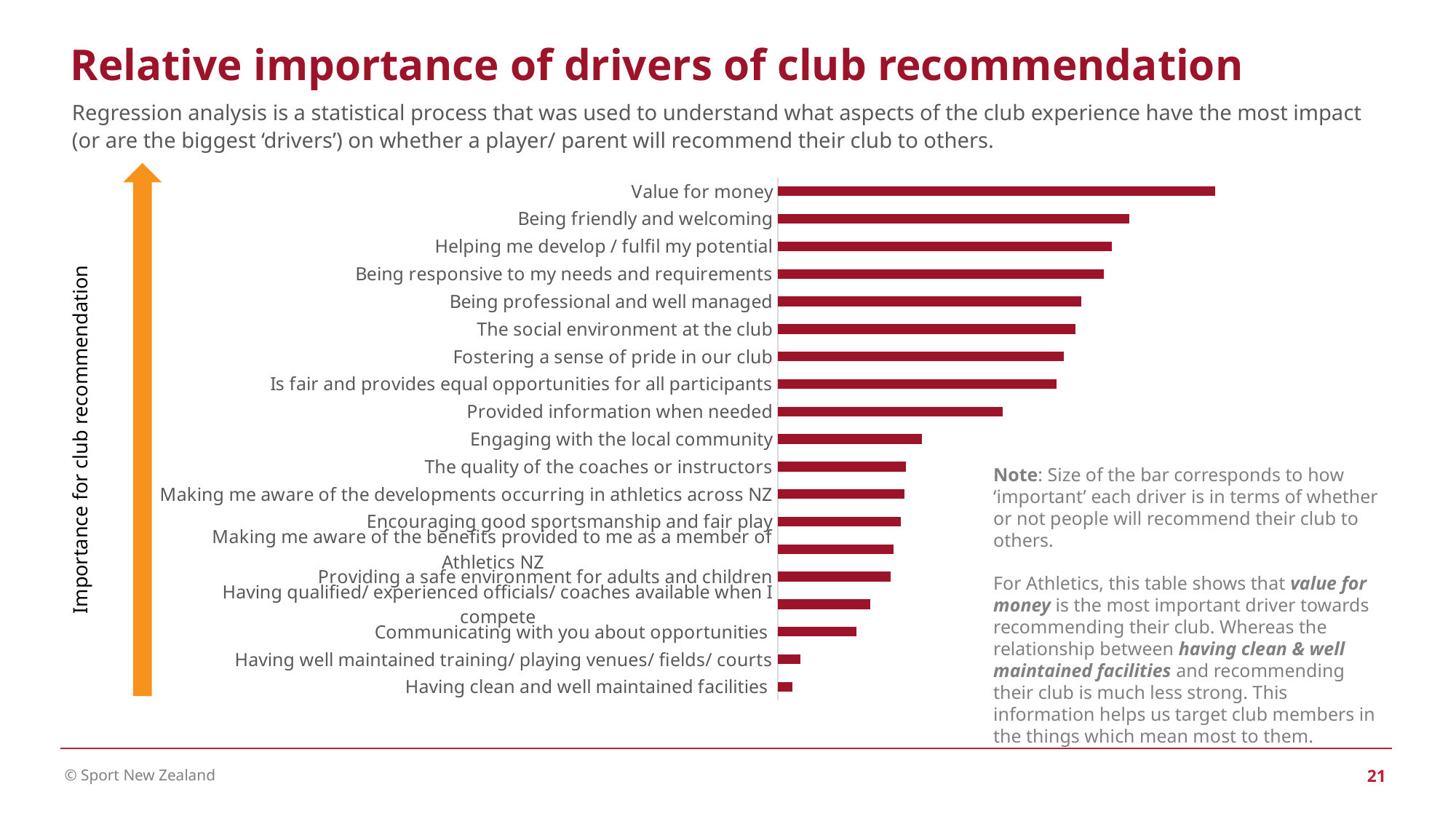
Which has the longer bar: Communicating with you about opportunities or Having well maintained training/ playing venues/ fields/ courts? Communicating with you about opportunities Which has the longer bar: Provided information when needed or Engaging with the local community? Provided information when needed Which driver has the longest bar in the chart? Value for money Which driver is listed second from the top of the chart? Being friendly and welcoming Which has the longer bar: Being professional and well managed or The quality of the coaches or instructors? Being professional and well managed What kind of chart is shown on the slide? Bar chart Which driver has the shortest bar in the chart? Having clean and well maintained facilities How many drivers (bars) are plotted in the chart? 19 Do the bar lengths increase or decrease going from the top of the chart to the bottom? Decrease What is the title of the slide containing the chart? Relative importance of drivers of club recommendation